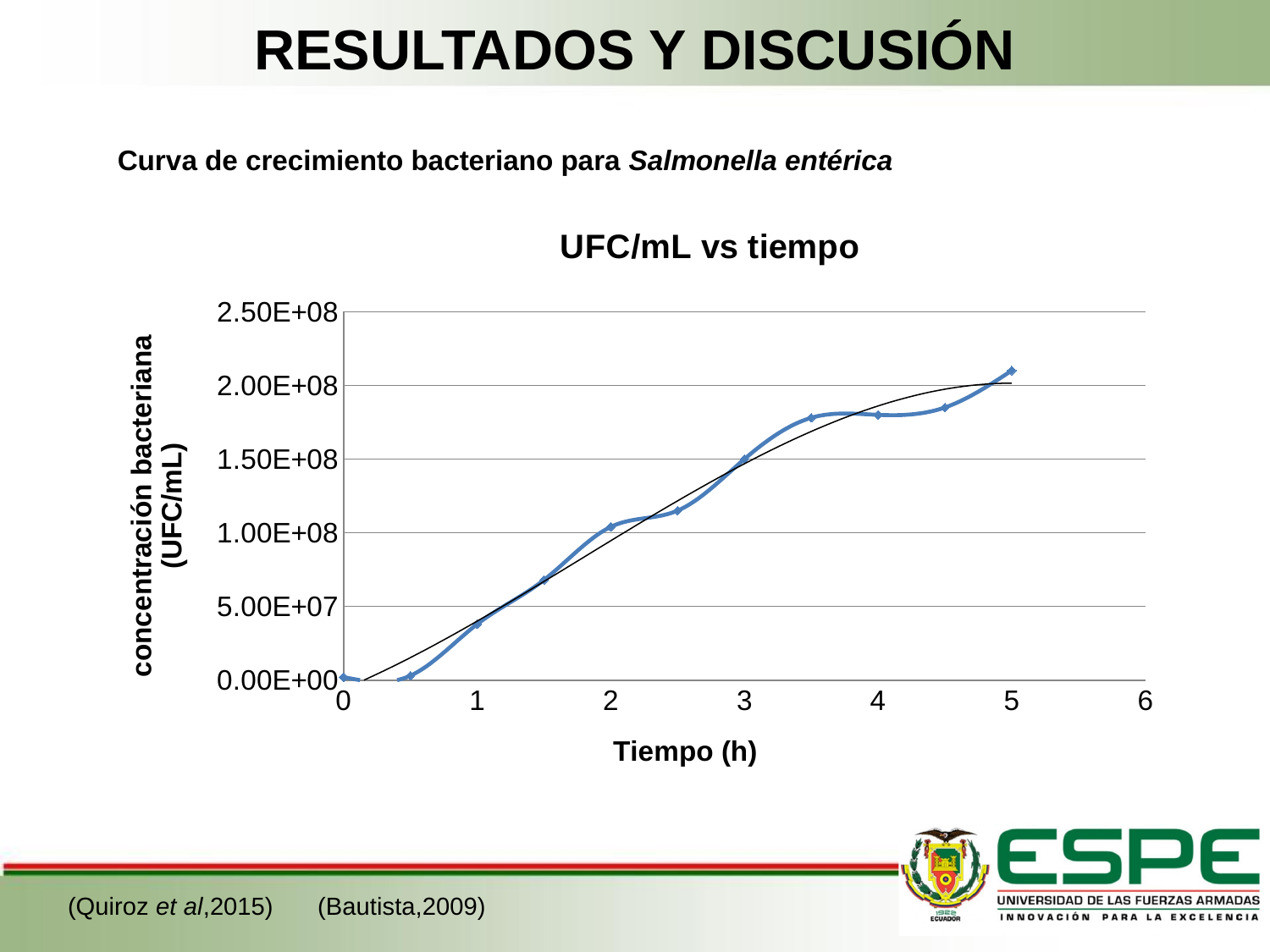
How many data points are plotted on the chart? 11 Is the value at 1 h greater or less than 5.00E+07? less Is the value at 2.5 h greater or less than 1.00E+08? greater What kind of chart is shown on the slide? line chart Is the value at 4.5 h greater or less than 2.00E+08? less What is the label of the x axis of the chart? Tiempo (h) At which time (h) is the bacterial concentration highest? 5 Do the values rise or fall as time increases along the x axis? rise What is the title of the chart? UFC/mL vs tiempo Which is larger, the value at 2 h or the value at 4 h? 4 h